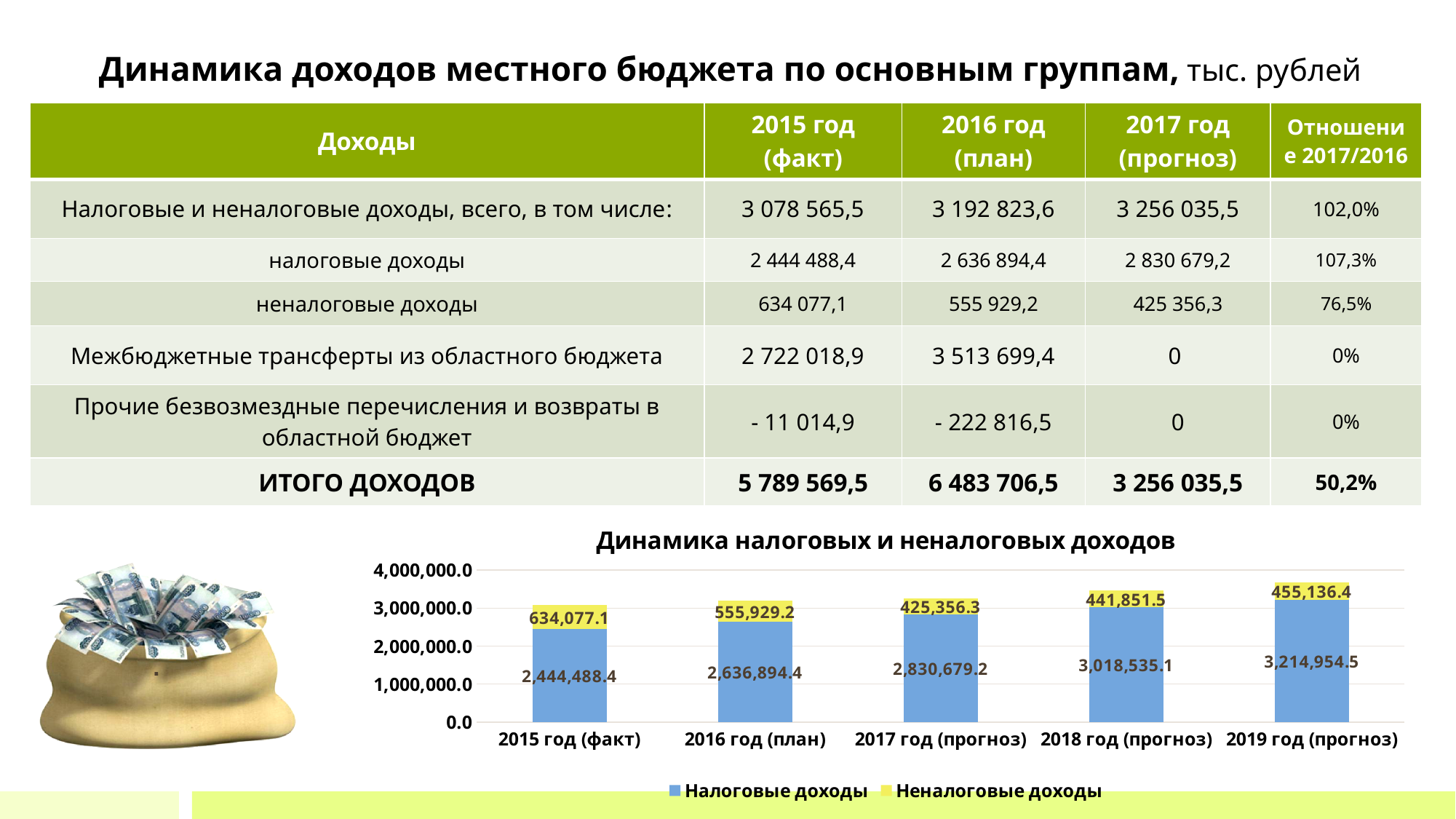
What is the difference between Налоговые доходы in 2019 год (прогноз) and 2015 год (факт)? 770,466.1 Is Неналоговые доходы larger in 2015 год (факт) or in 2018 год (прогноз)? 2015 год (факт) What is the value of Налоговые доходы for 2017 год (прогноз) in the chart? 2,830,679.2 Which year has the lowest value of Неналоговые доходы in the chart? 2017 год (прогноз) How many year categories are shown on the x axis of the chart? 5 What is the title of the chart on the slide? Динамика налоговых и неналоговых доходов How many series does the chart legend list? 2 Which year has the highest value of Налоговые доходы in the chart? 2019 год (прогноз) What type of chart is shown on the slide? Stacked bar chart Do the values of Налоговые доходы rise or fall from 2015 to 2019 in the chart? Rise What is the value of Неналоговые доходы for 2019 год (прогноз) in the chart? 455,136.4 What is the total of the stacked bar for 2016 год (план)? 3,192,823.6